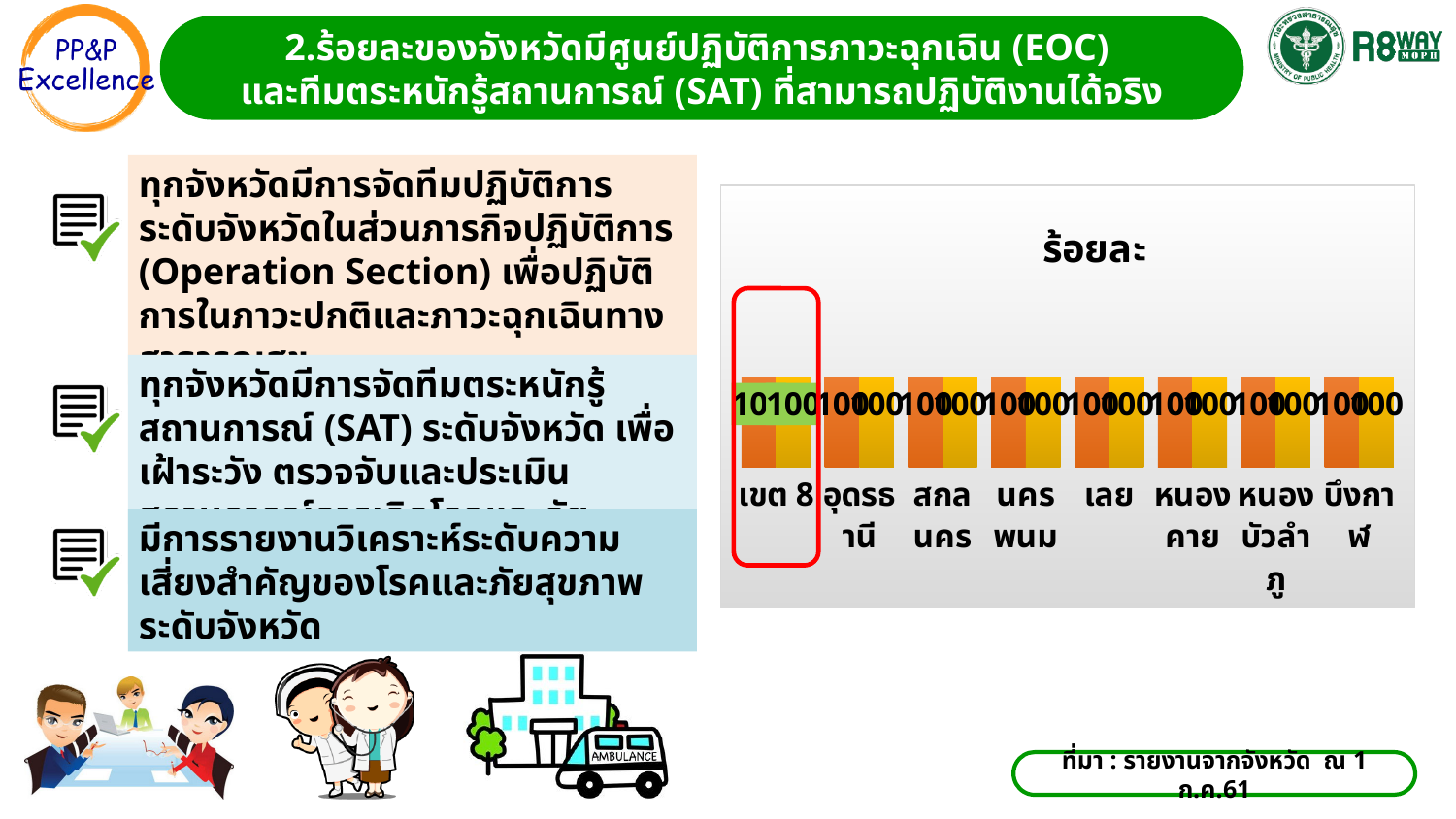
What is the value labelled for เขต 8 in the chart? 100 How many categories are shown on the x axis of the chart? 8 What is the difference between the value for สกลนคร and the value for นครพนม in the chart? 0 Which category is shown first (leftmost) on the x axis of the chart? เขต 8 Is the value for อุดรธานี larger than, smaller than, or equal to the value for เลย in the chart? equal What type of chart is shown on the slide? bar chart What is the value labelled for บึงกาฬ in the chart? 100 What is the title of the chart on the slide? ร้อยละ Do the values in the chart rise, fall, or stay the same across the categories from left to right? stay the same